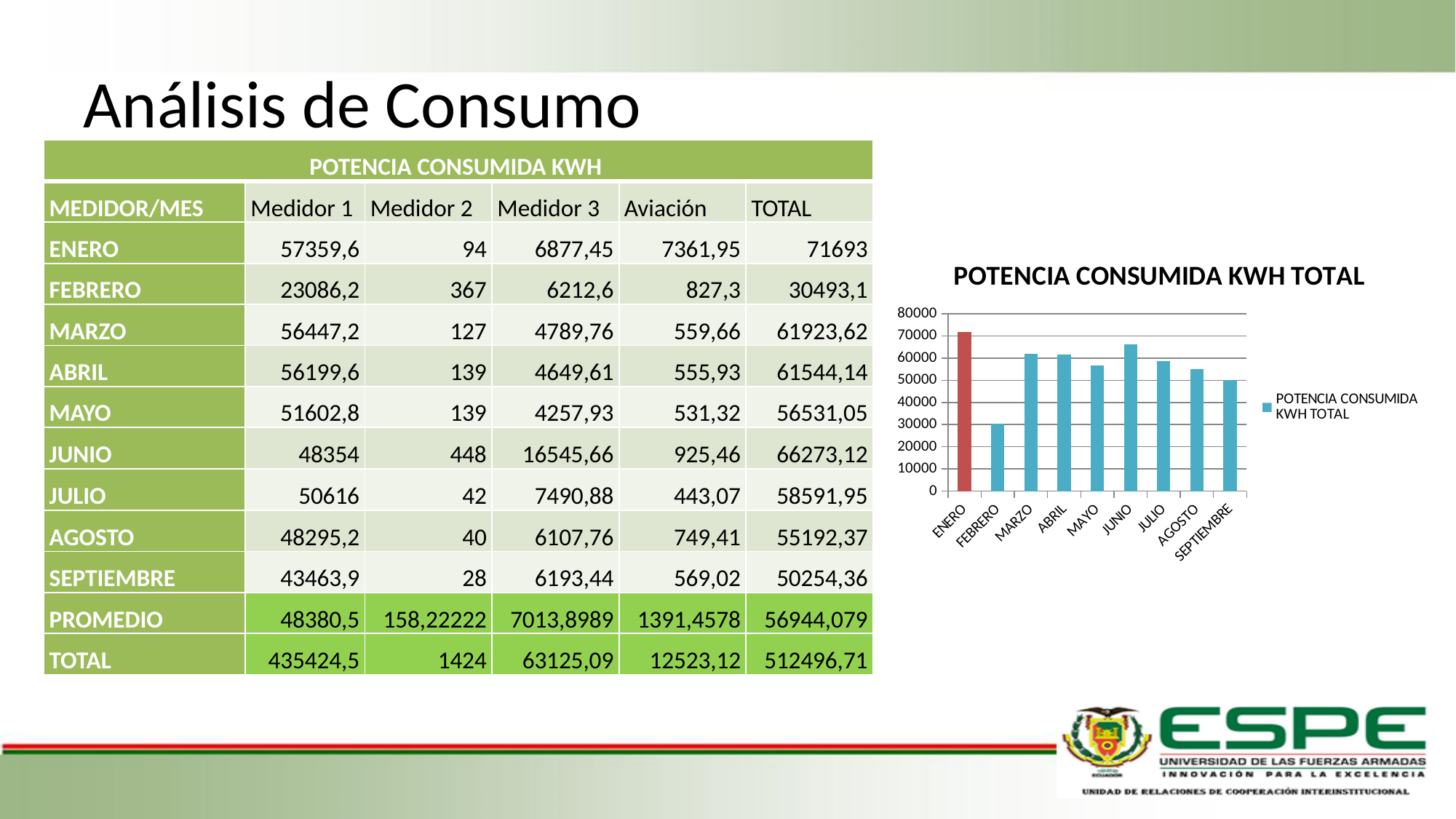
What is the title of the chart? POTENCIA CONSUMIDA KWH TOTAL How many months are plotted on the x axis of the chart? 9 Is the value for SEPTIEMBRE greater or less than 60000? less Do the values rise or fall from JUNIO to SEPTIEMBRE? fall What type of chart is shown on the slide? bar chart Which bar in the chart is coloured red instead of blue? ENERO Which is larger in the chart, the value for JUNIO or the value for JULIO? JUNIO Is the value for FEBRERO greater or less than 40000? less Which month has the highest bar in the chart? ENERO Is the value for JUNIO greater or less than 60000? greater How many series does the chart legend list? 1 Which month has the lowest bar in the chart? FEBRERO